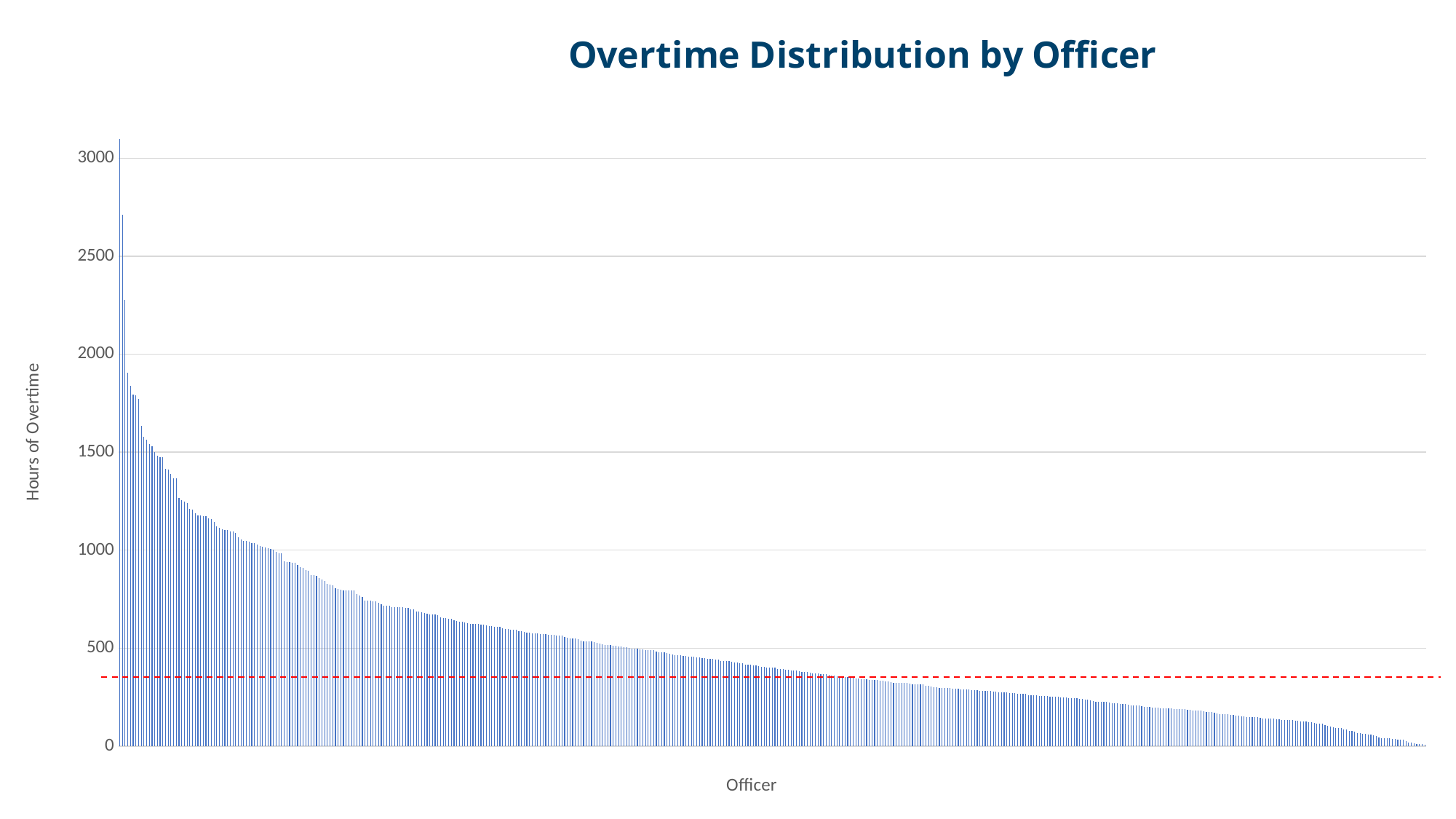
What is the title of the chart? Overtime Distribution by Officer What kind of chart is shown on the slide? bar chart Is the value of the tallest bar greater or less than 2500? greater Is the value of the second-tallest bar greater or less than 3000? less Is the level of the red dashed horizontal line greater or less than 500? less What is the highest value shown on the vertical axis? 3000 What is the label on the vertical axis? Hours of Overtime Which bar is the tallest: the leftmost bar or the rightmost bar? the leftmost bar Do the bar values rise or fall from left to right along the x axis? fall